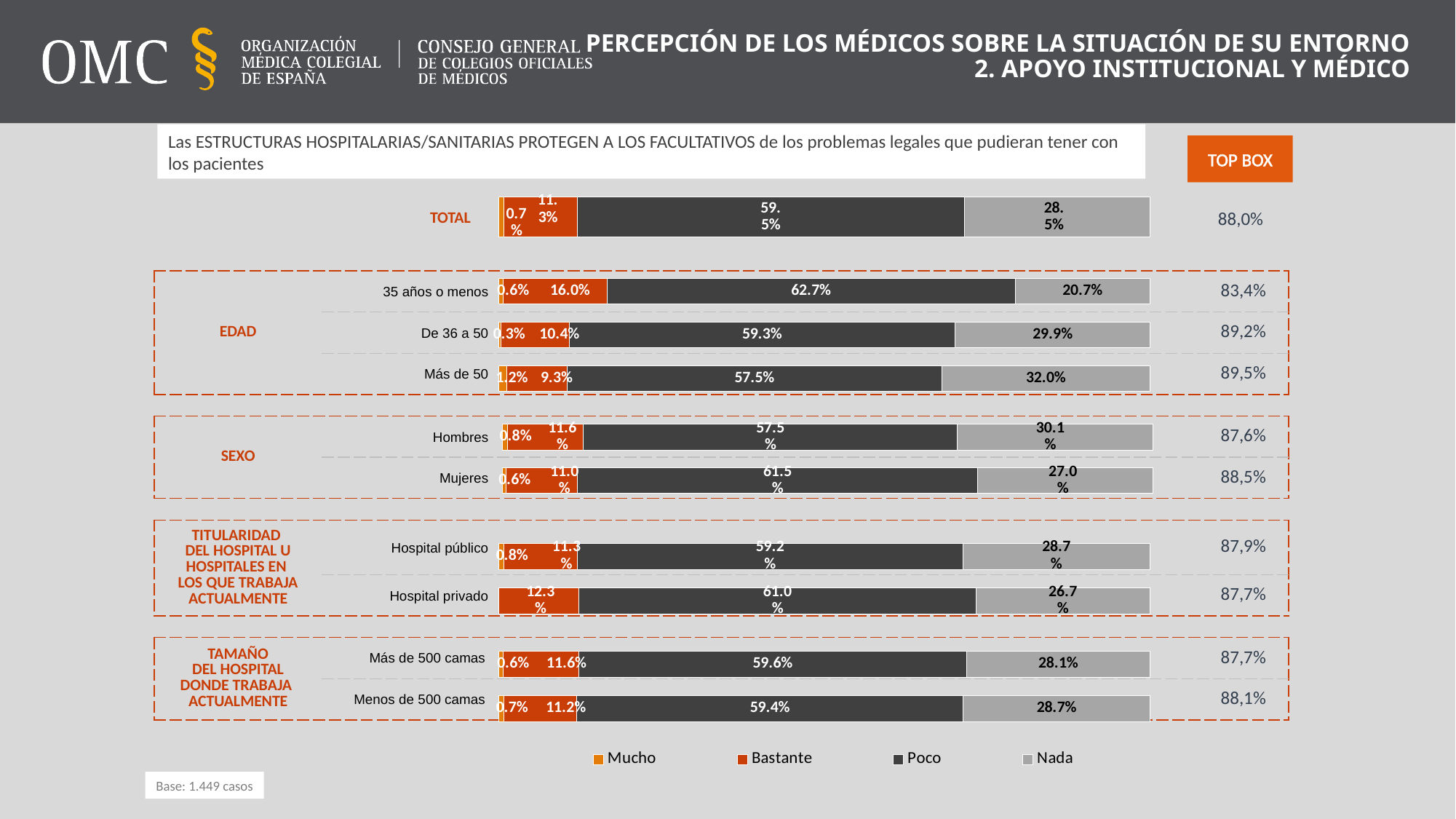
Which category has the lowest Nada value? 35 años o menos What is the value of the Poco segment for the '35 años o menos' bar? 62.7% What is the difference between the Poco values for Mujeres and Hombres? 4.0 percentage points What is the value of the Bastante segment for the 'Hospital privado' bar? 12.3% What is the TOP BOX value shown for 'Más de 50'? 89,5% How many series does the legend list? 4 What is the value of the Nada segment for the 'Más de 50' bar? 32.0% What kind of chart is shown on the slide? Stacked bar chart How many bars (categories) are plotted in the chart, including TOTAL? 10 What are the legend entries of the chart? Mucho, Bastante, Poco, Nada Which has a larger Nada value, 'De 36 a 50' or 'Hospital público'? De 36 a 50 Which category has the highest Bastante value? 35 años o menos